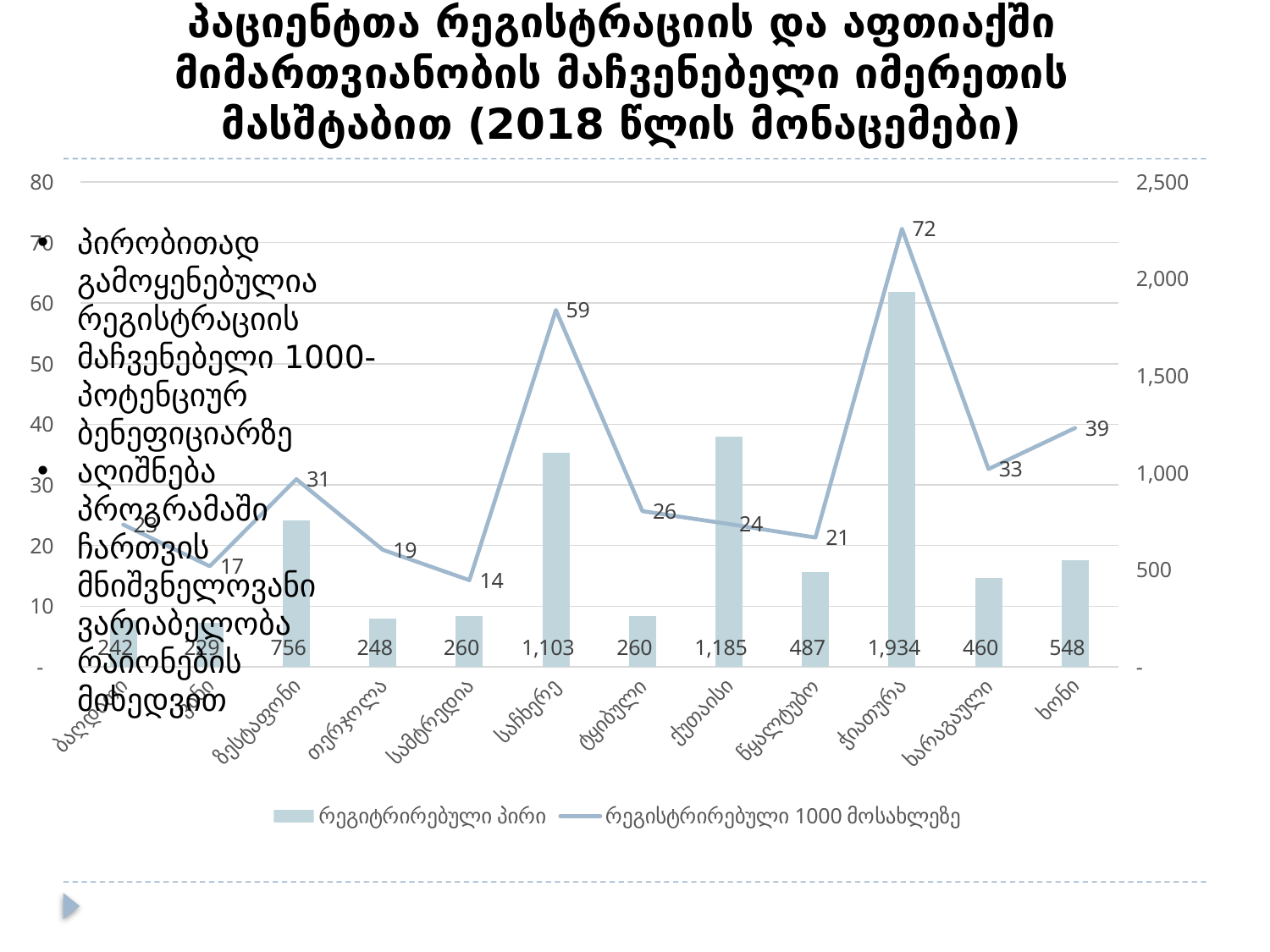
What is the value of რეგიტრირებული პირი for ჭიათურა? 1,934 What is the difference in რეგისტრირებული 1000 მოსახლეზე between ჭიათურა and ხარაგაული? 39 Which category has the highest value of რეგისტრირებული 1000 მოსახლეზე? ჭიათურა What kind of chart is shown on the slide? Combined bar and line chart What is the value of რეგისტრირებული 1000 მოსახლეზე for საჩხერე? 59 Which category has the highest value of რეგიტრირებული პირი? ჭიათურა What is the difference in რეგიტრირებული პირი between ქუთაისი and საჩხერე? 82 What is the value of რეგიტრირებული პირი for წყალტუბო? 487 Which has a higher value of რეგიტრირებული პირი, ხონი or ხარაგაული? ხონი Which category has the lowest value of რეგისტრირებული 1000 მოსახლეზე? სამტრედია What is the value of რეგისტრირებული 1000 მოსახლეზე for ხონი? 39 How many series does the legend list? 2